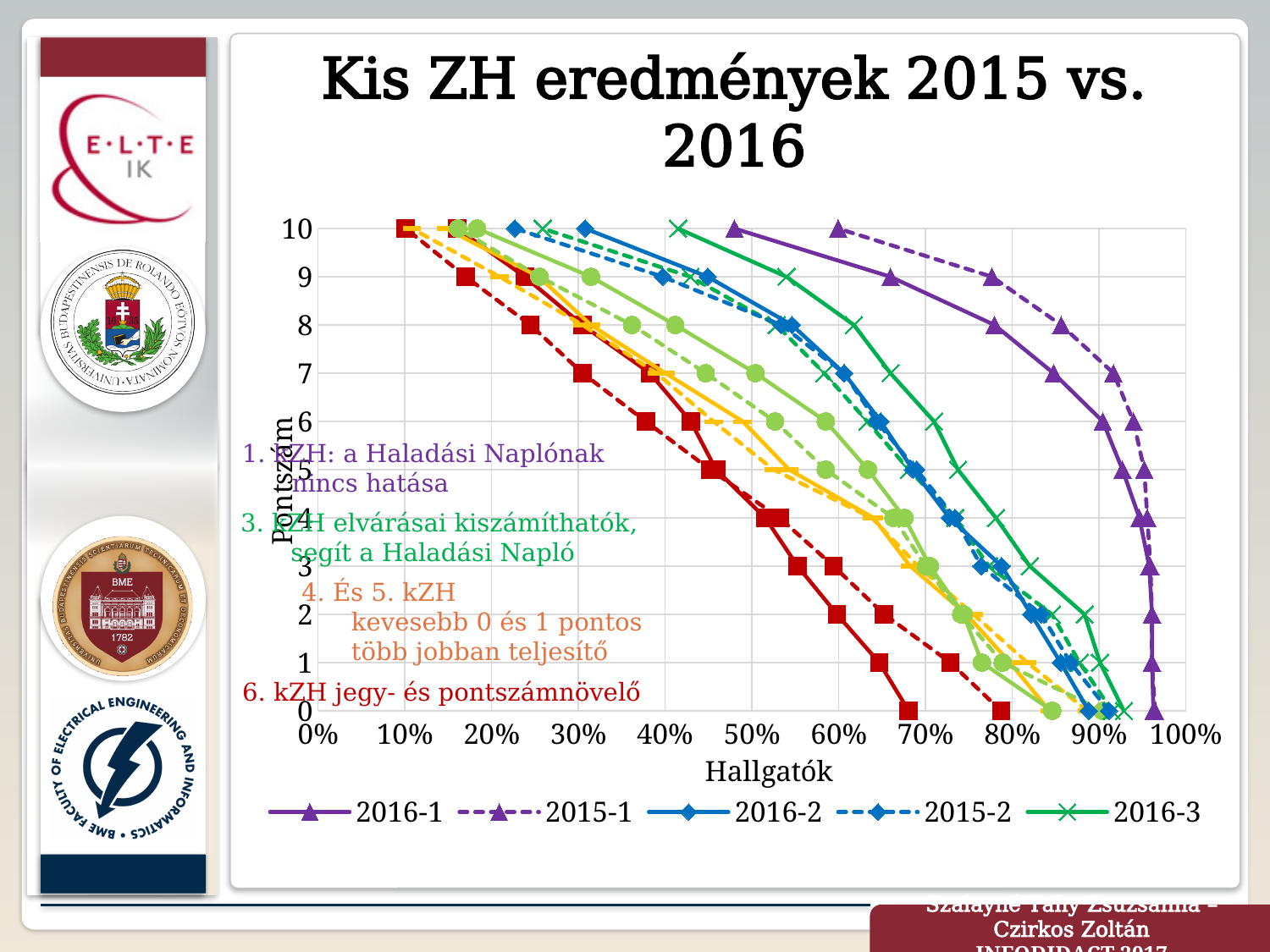
At Pontszám 10, which series has the larger Hallgatók value, 2016-1 or 2015-1? 2015-1 Is the Hallgatók value for the 2016-2 series at Pontszám 10 greater or less than 30%? less At Pontszám 0, which series has the larger Hallgatók value, 2016-1 or 2016-2? 2016-1 Is the Hallgatók value for the 2016-3 series at Pontszám 0 greater or less than 90%? greater What is the label of the x axis of the chart? Hallgatók How many entries are visible in the chart's legend? 5 What kind of chart is shown on the slide? line chart What is the highest value shown on the Pontszám axis? 10 What is the title of the chart? Kis ZH eredmények 2015 vs. 2016 Is the Hallgatók value for the 2015-1 series at Pontszám 10 greater or less than 50%? greater As Hallgatók increases along the x axis, do the Pontszám values of the 2016-1 series rise or fall? fall